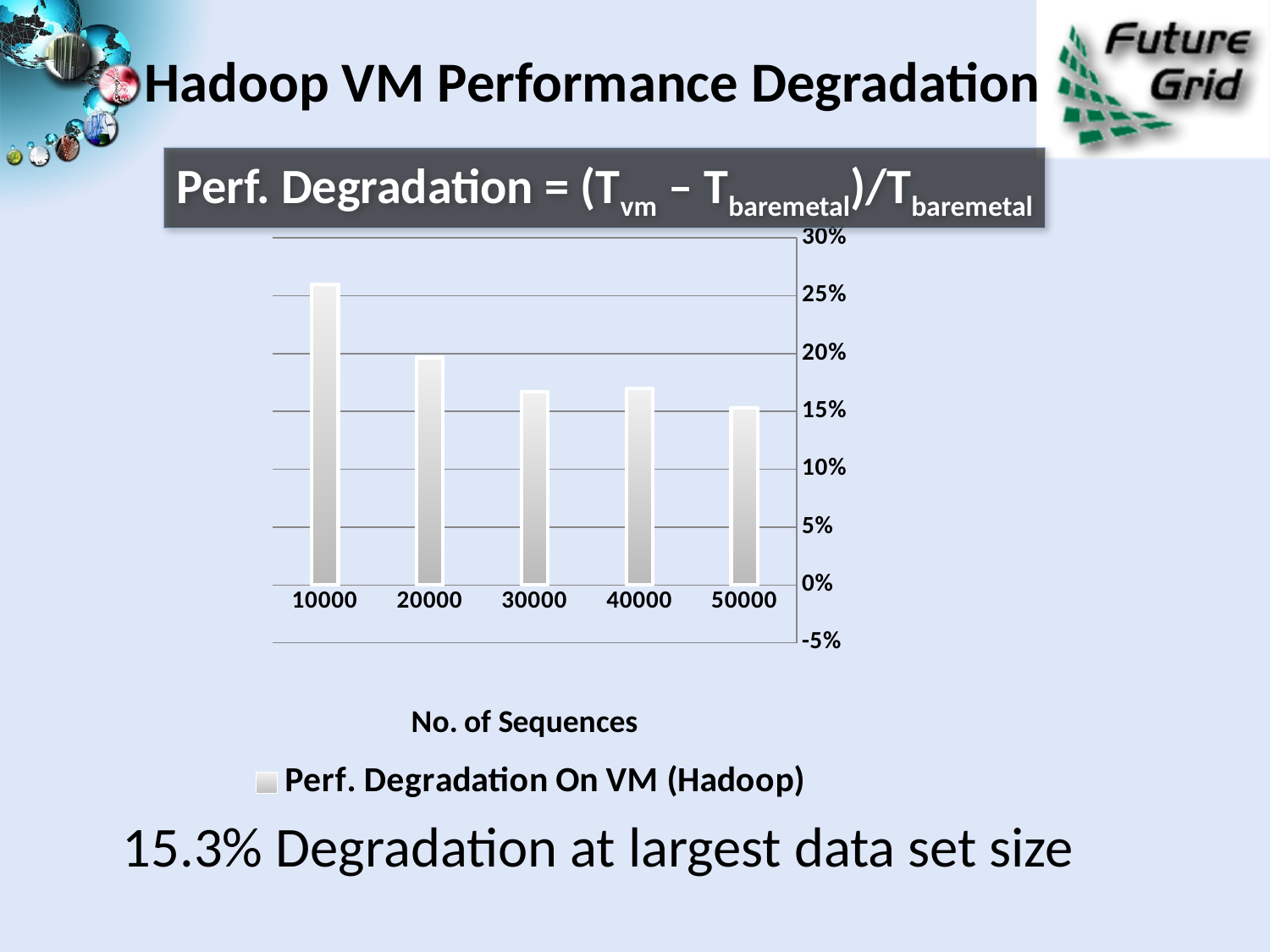
According to the slide, what is the performance degradation at the largest data set size (50000 sequences)? 15.3% Which number of sequences has the highest performance degradation? 10000 Which number of sequences has the lowest performance degradation? 50000 What is the title of the x axis? No. of Sequences What kind of chart is shown on the slide? bar chart Is the performance degradation for 40000 sequences greater or less than 20%? less Which has a larger performance degradation, 10000 sequences or 20000 sequences? 10000 How many series does the legend list? 1 What is the name of the series shown in the legend? Perf. Degradation On VM (Hadoop) Is the performance degradation for 10000 sequences greater or less than 25%? greater How many categories (numbers of sequences) are plotted on the x axis? 5